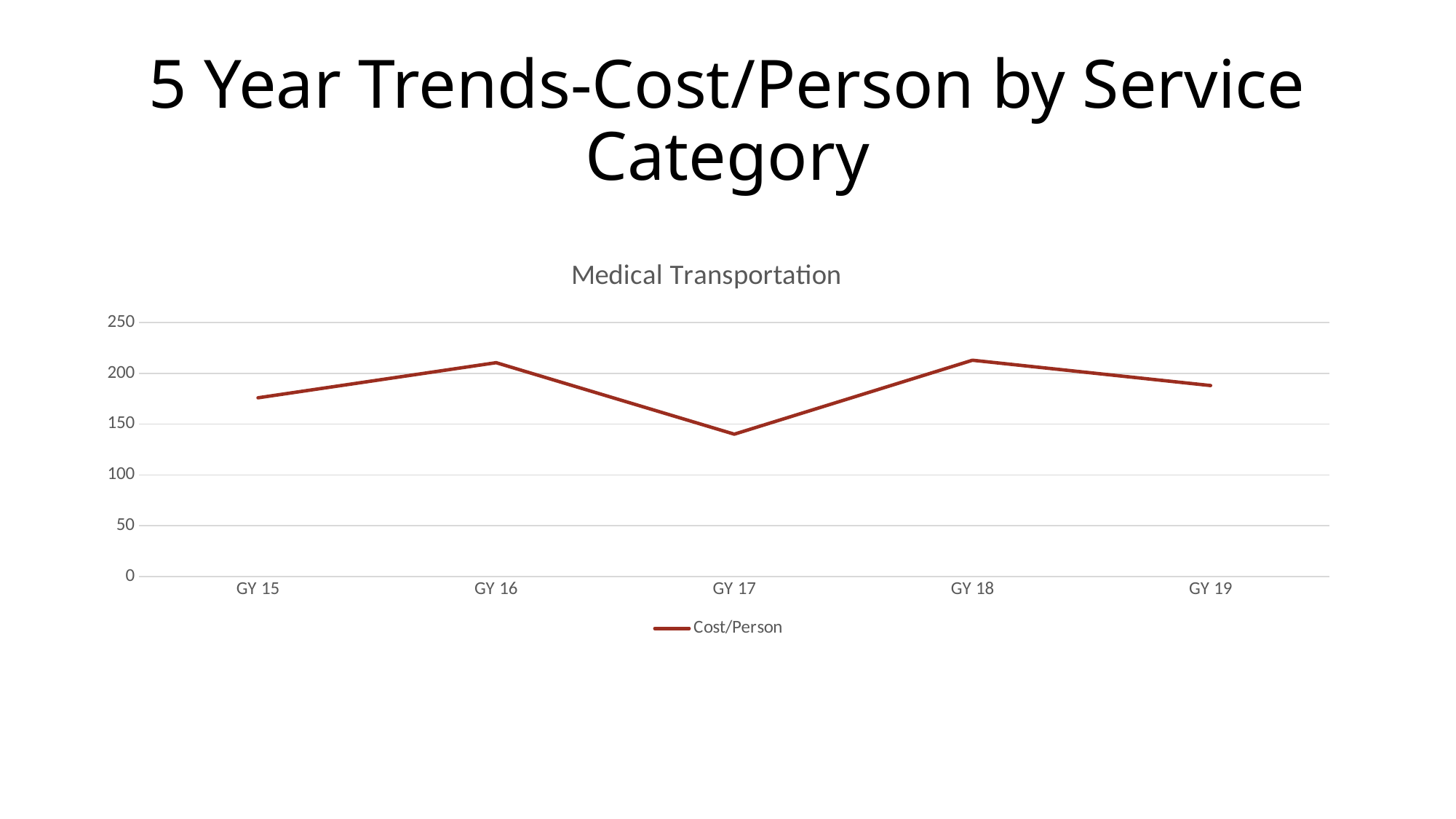
Does the Cost/Person rise or fall from GY 16 to GY 17? fall How many series does the legend list? 1 How many years are plotted on the x axis? 5 What series name does the legend show? Cost/Person Which is larger, the Cost/Person for GY 18 or for GY 19? GY 18 Is the Cost/Person for GY 16 greater or less than 200? greater What kind of chart is shown on the slide? line chart Which is larger, the Cost/Person for GY 15 or for GY 17? GY 15 Is the Cost/Person for GY 15 greater or less than 150? greater What is the title of the chart? Medical Transportation Which year has the lowest Cost/Person? GY 17 Is the Cost/Person for GY 19 greater or less than 200? less